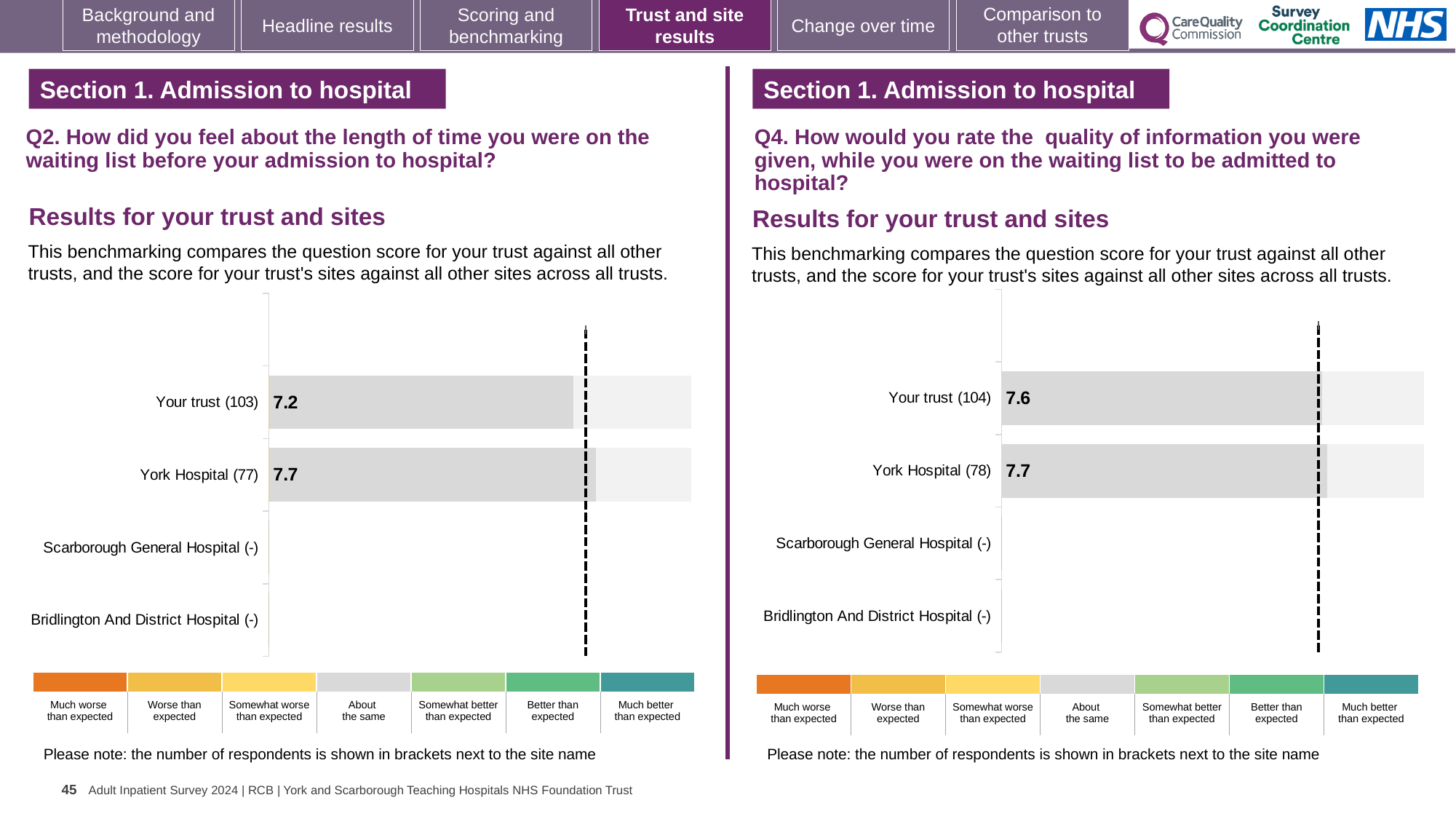
In the right chart (Q4), how many respondents are shown in brackets for York Hospital? 78 How many categories are listed on the y axis of the left chart (Q2)? 4 In the right chart (Q4), what is the score for Your trust? 7.6 In the left chart (Q2), how many respondents are shown in brackets for Your trust? 103 In the left chart (Q2), which has the higher score, Your trust or York Hospital? York Hospital What kind of chart is the right chart (Q4)? Bar chart In the right chart (Q4), what is the difference between the York Hospital score and the Your trust score? 0.1 In the left chart (Q2), which two sites have no score shown (marked with a dash)? Scarborough General Hospital and Bridlington And District Hospital In the right chart (Q4), what is the score for York Hospital? 7.7 In the left chart (Q2), what is the difference between the York Hospital score and the Your trust score? 0.5 In the left chart (Q2), what is the score for Your trust? 7.2 In the left chart (Q2), what is the score for York Hospital? 7.7